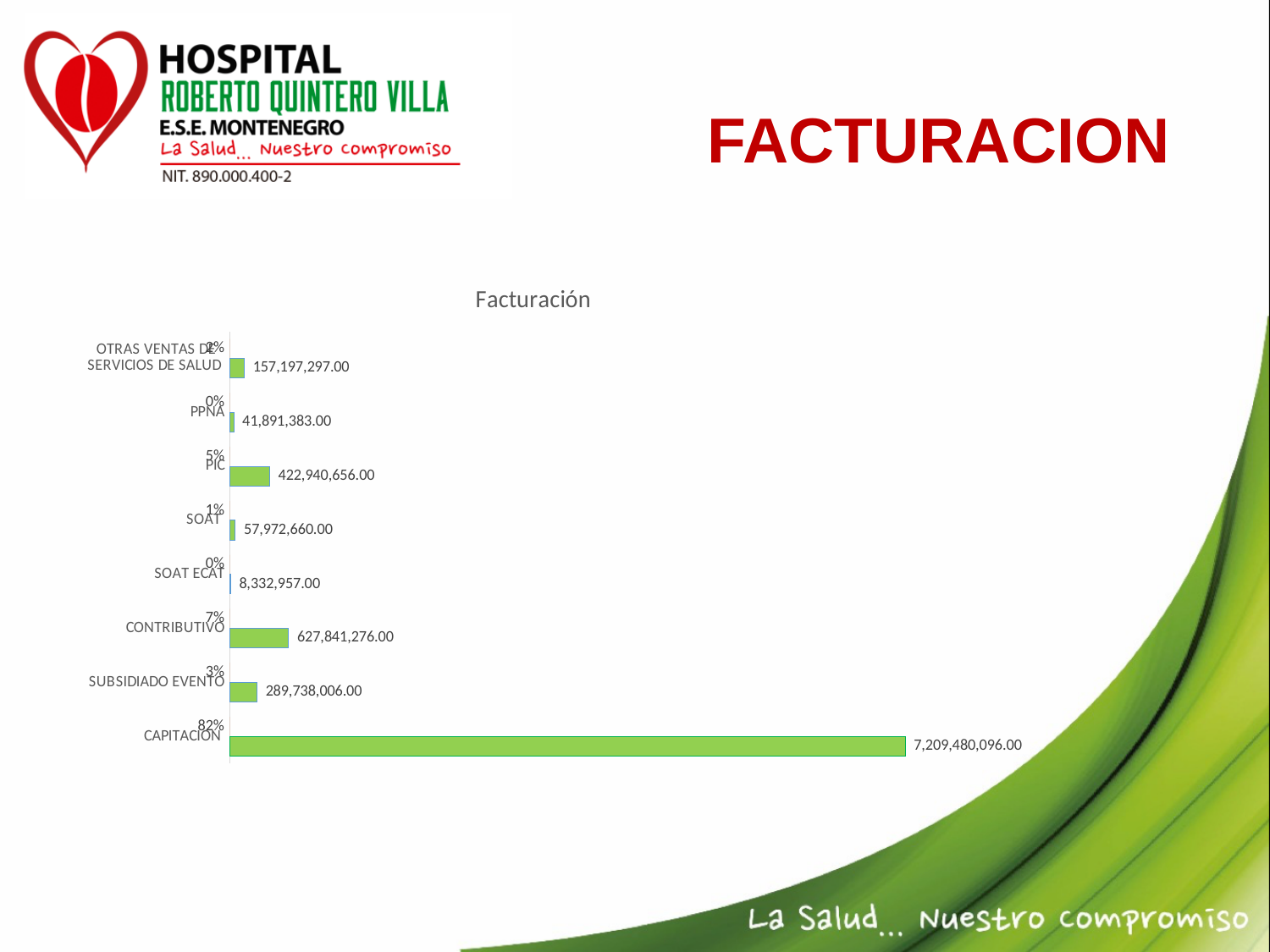
What is the value for SOAT ECAT? 8,332,957.00 What is the chart's title? Facturación What percentage is shown for CAPITACIÓN? 82% How many categories are shown in the chart? 8 What type of chart is shown on the slide? bar chart Which category has the highest value? CAPITACIÓN What is the value for CAPITACIÓN? 7,209,480,096.00 What is the difference between the values for CONTRIBUTIVO and SUBSIDIADO EVENTO? 338,103,270.00 What is the value for CONTRIBUTIVO? 627,841,276.00 Which is larger, SUBSIDIADO EVENTO or PIC? PIC What is the value for PIC? 422,940,656.00 Which category has the lowest value? SOAT ECAT